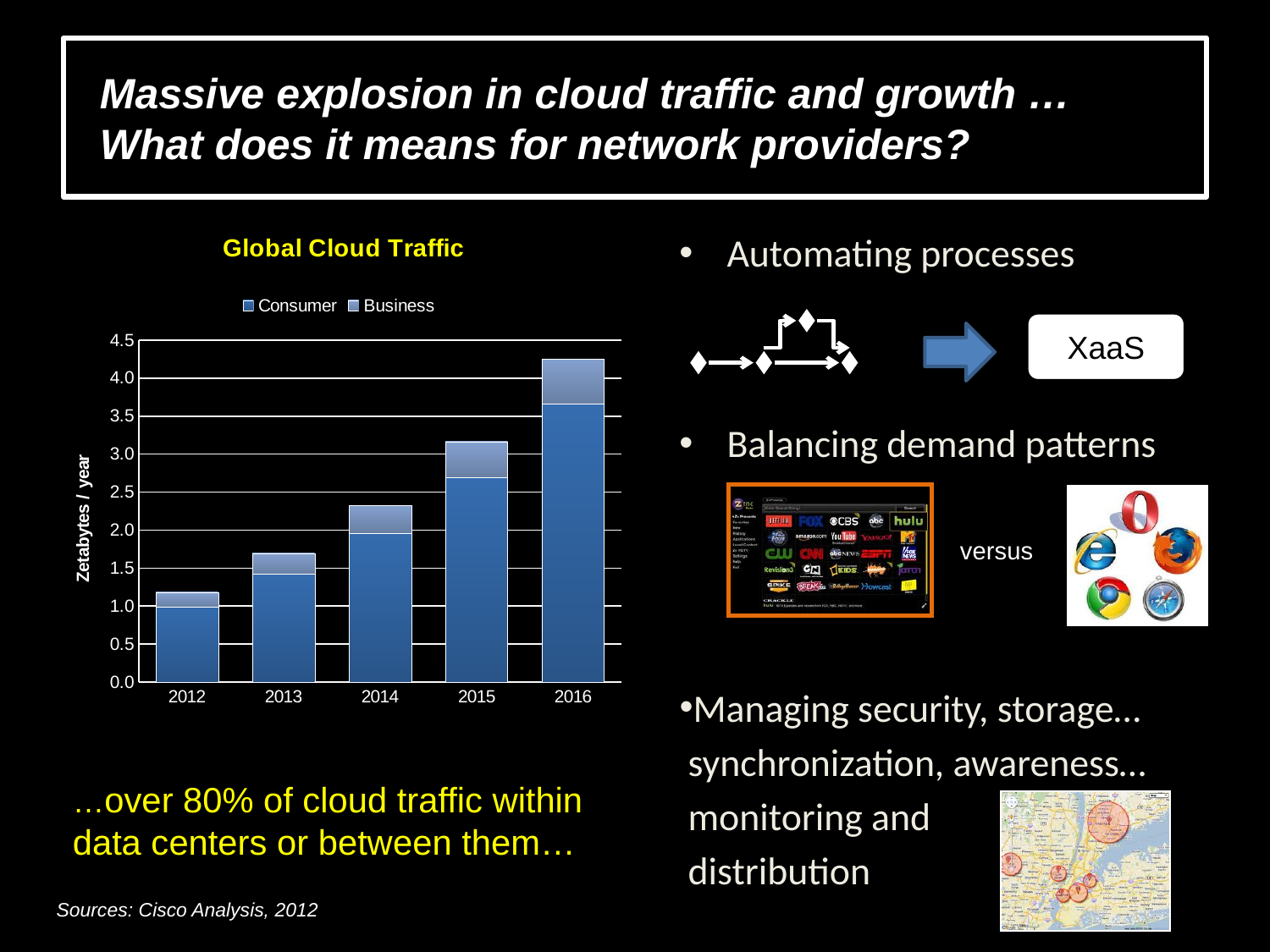
What is the y-axis label of the Global Cloud Traffic chart? Zetabytes / year Is the total cloud traffic for 2012 greater or less than 1.5 zetabytes per year? less Which series is larger in every year of the Global Cloud Traffic chart, Consumer or Business? Consumer What type of chart is the Global Cloud Traffic chart? stacked bar chart Is the total cloud traffic for 2016 greater or less than 4.0 zetabytes per year? greater Which year has the highest total cloud traffic in the Global Cloud Traffic chart? 2016 Is the total cloud traffic for 2014 greater or less than 2.5 zetabytes per year? less Which year has the lowest total cloud traffic in the Global Cloud Traffic chart? 2012 How many series does the legend of the Global Cloud Traffic chart list? 2 How many years are shown on the x axis of the Global Cloud Traffic chart? 5 Which series are listed in the legend of the Global Cloud Traffic chart? Consumer and Business Does total cloud traffic rise or fall from 2012 to 2016 in the Global Cloud Traffic chart? rise